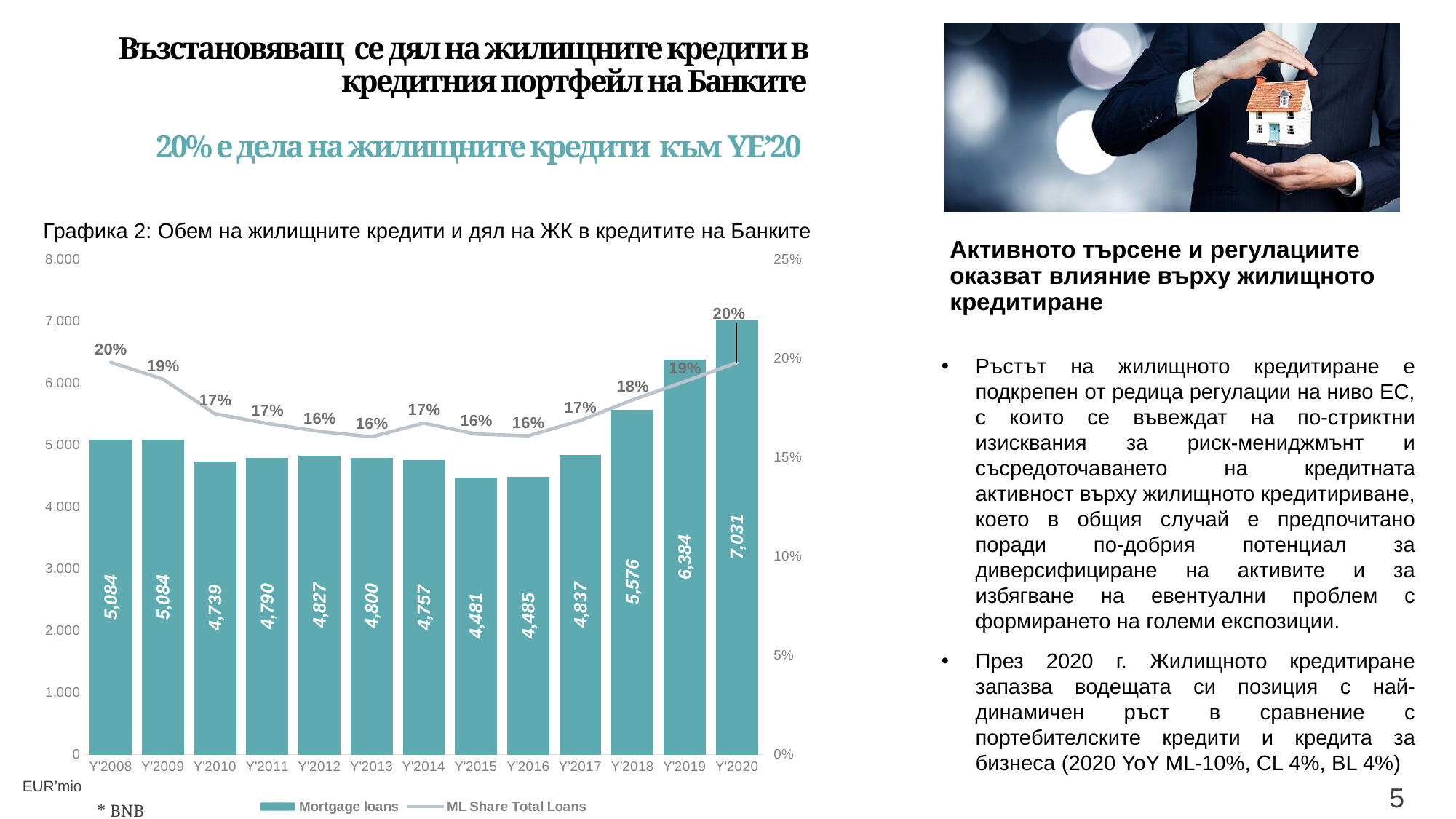
What is the difference in Mortgage loans between Y'2020 and Y'2019? 647 What is the ML Share Total Loans value for Y'2018? 18% Do the Mortgage loans values rise or fall from Y'2016 to Y'2020? Rise Which year has the lowest Mortgage loans value? Y'2015 What is the value of Mortgage loans for Y'2015? 4,481 What kind of chart is used to show Mortgage loans? Bar chart How many years are shown on the x axis of the chart? 13 What unit is indicated below the chart for the Mortgage loans values? EUR'mio Which is larger, the Mortgage loans value for Y'2017 or for Y'2012? Y'2017 How many series does the legend list? 2 Which year has the highest Mortgage loans value? Y'2020 What is the value of Mortgage loans for Y'2020? 7,031